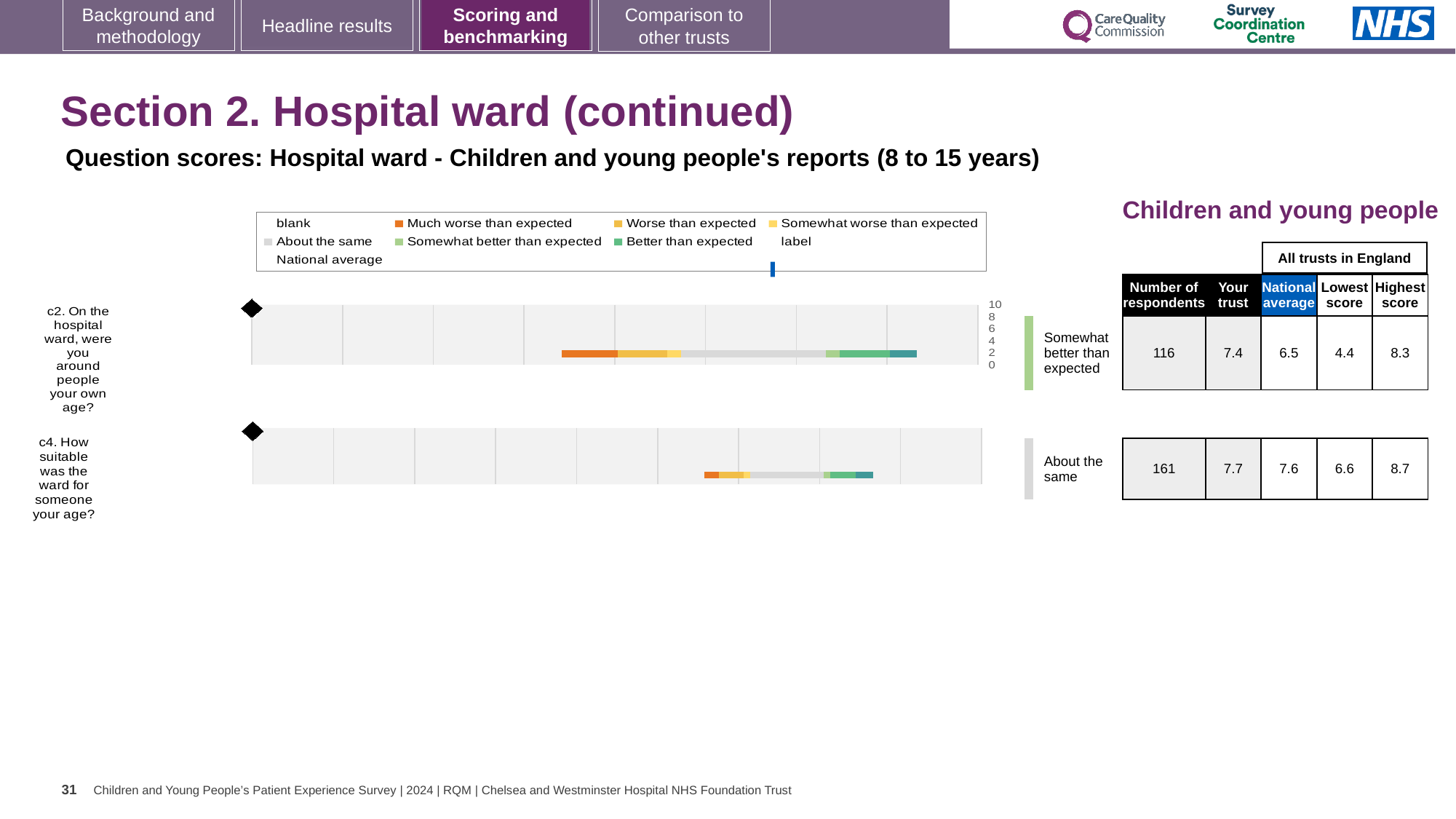
How many questions are plotted on the slide? 2 Which benchmarking category is shown for question c2? Somewhat better than expected What is the national average score for question c2? 6.5 What is the 'Your trust' score for question c4 (How suitable was the ward for someone your age?)? 7.7 What kind of chart is used to show the question scores for c2 and c4? bar chart What is the difference between the trust's score and the national average for question c2? 0.9 Which question has the higher 'Your trust' score, c2 or c4? c4 For question c2, is the trust's score higher or lower than the national average? higher What is the 'Your trust' score for question c2 (On the hospital ward, were you around people your own age?)? 7.4 What is the difference between the highest and lowest scores across all trusts in England for question c2? 3.9 What is the number of respondents for question c4? 161 What is the highest score among all trusts in England for question c4? 8.7